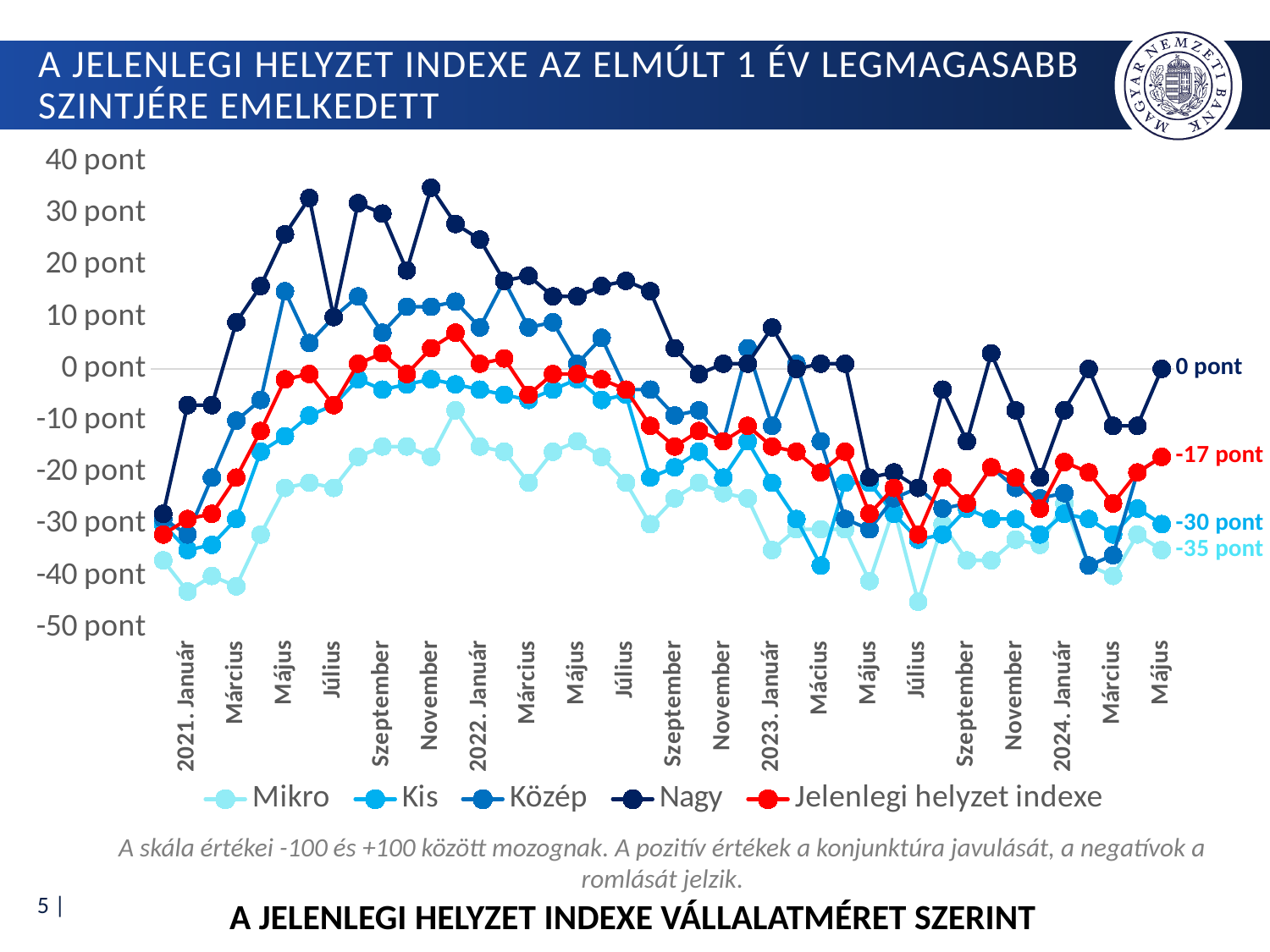
How many series does the legend list? 5 Is the value for Nagy in Május 2021 greater or less than 20 pont? greater What kind of chart is shown on the slide? line chart What is the value of the Nagy series in Május 2024? 0 pont Which series has the highest value in Május 2024? Nagy Is the value for Mikro in 2021. Január greater or less than -30 pont? less What is the title printed below the chart? A JELENLEGI HELYZET INDEXE VÁLLALATMÉRET SZERINT Which series has the higher value in Május 2024, Nagy or Mikro? Nagy What is the value of the Mikro series in Május 2024? -35 pont Which series has the lowest value in Május 2024? Mikro What is the difference between the Nagy value and the Jelenlegi helyzet indexe value in Május 2024? 17 pont What is the value of the Jelenlegi helyzet indexe series in Május 2024? -17 pont